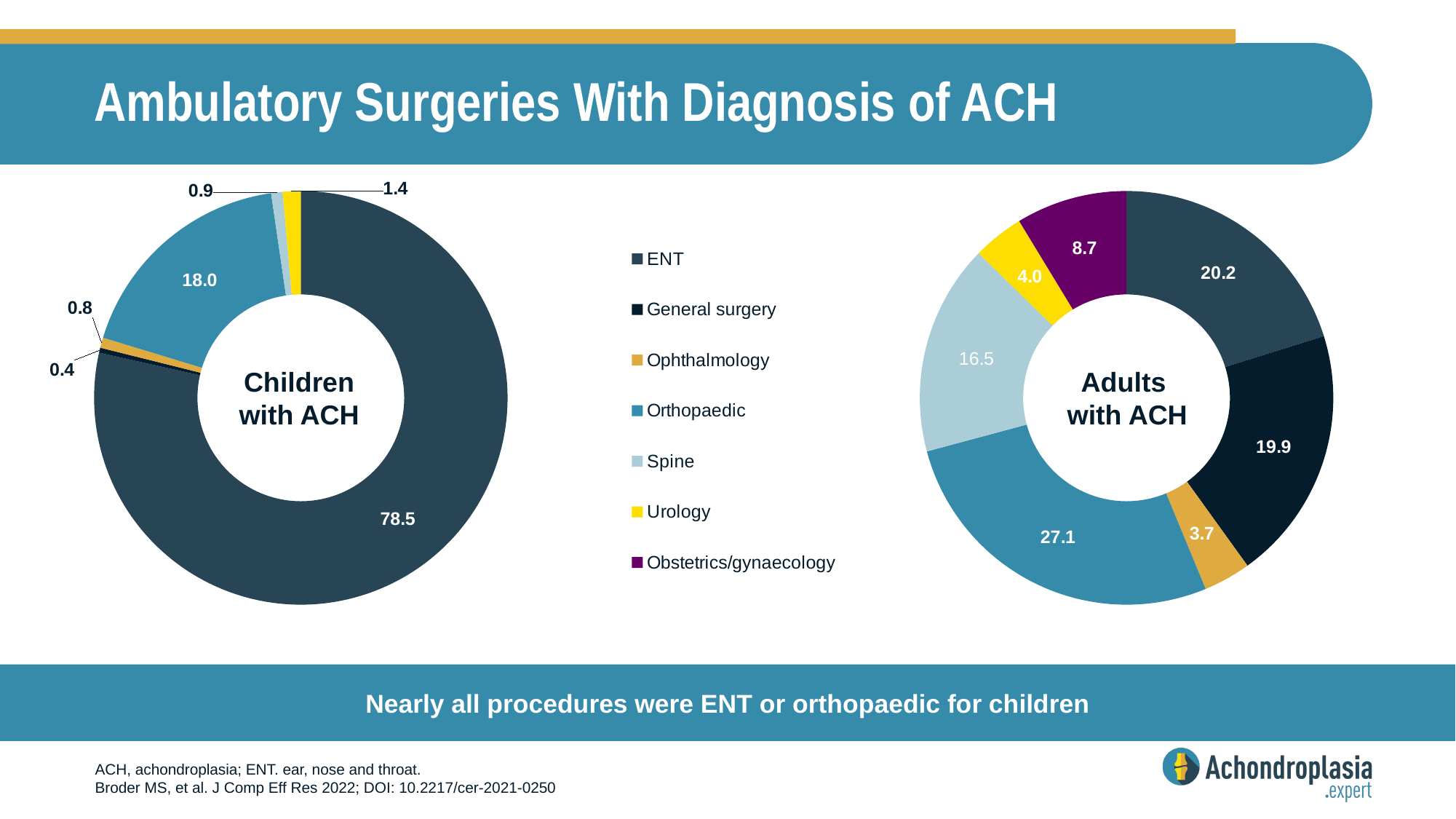
In the 'Children with ACH' chart, what is the value for Orthopaedic? 18.0 In the 'Children with ACH' chart, what is the value for ENT? 78.5 What is the title of the slide? Ambulatory Surgeries With Diagnosis of ACH In the 'Adults with ACH' chart, what is the value for Spine? 16.5 How many categories does the legend list? 7 In the 'Adults with ACH' chart, which category has the highest value? Orthopaedic In the 'Adults with ACH' chart, what is the value for Obstetrics/gynaecology? 8.7 In the 'Adults with ACH' chart, what is the difference between the Orthopaedic value and the ENT value? 6.9 What kind of chart is used for 'Adults with ACH'? Donut (pie) chart In the 'Adults with ACH' chart, which is larger: Urology or Ophthalmology? Urology In the 'Children with ACH' chart, what is the difference between the ENT value and the Orthopaedic value? 60.5 In the 'Children with ACH' chart, which category has the lowest value? General surgery